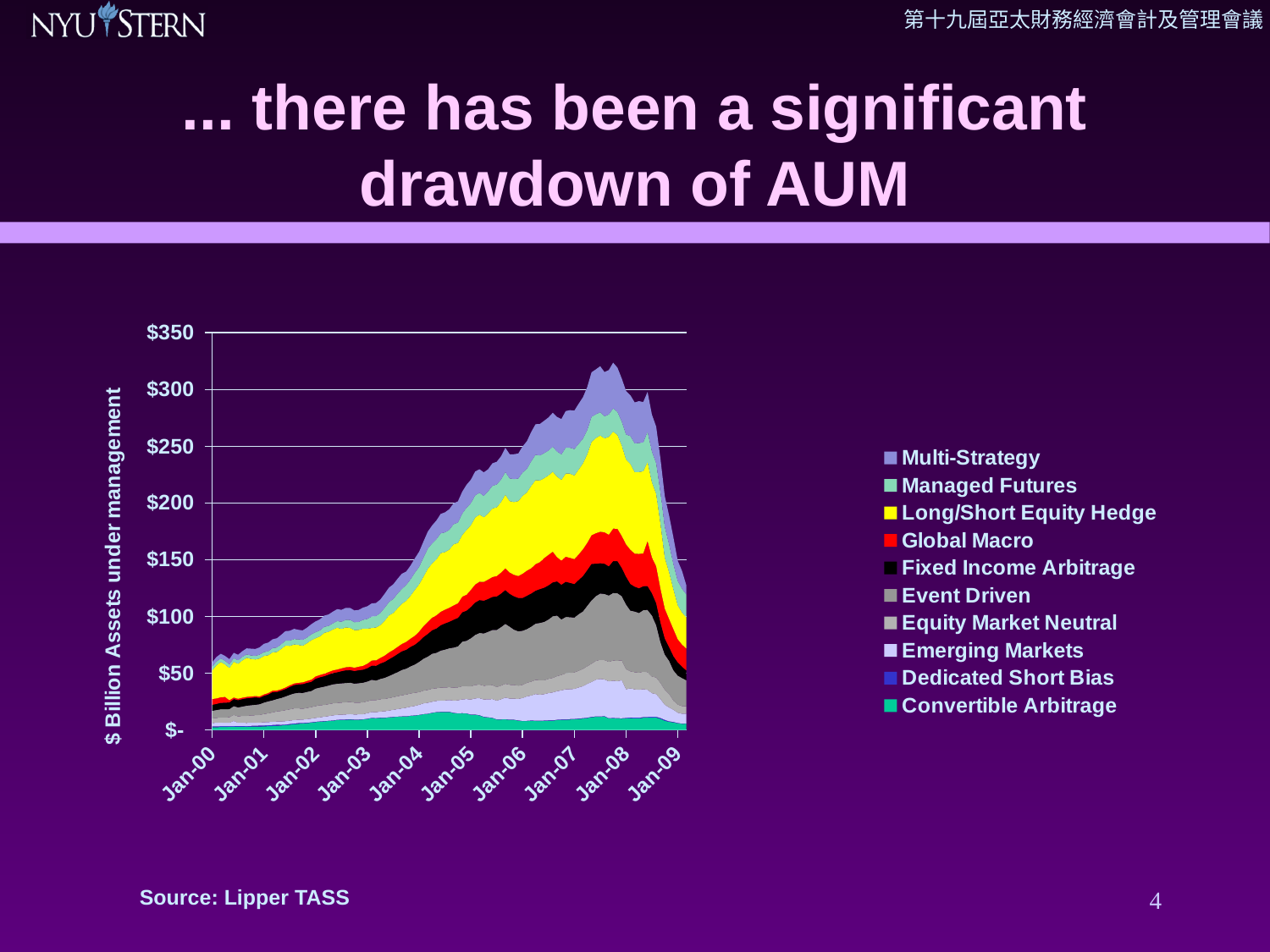
Is the peak total assets under management (around 2008) greater or less than $300? greater Is the total assets under management at Jan-09 greater or less than $200? less How many series does the legend list? 10 Is the total assets under management at Jan-05 greater or less than $200? greater Does total assets under management rise or fall from Jan-08 to Jan-09? fall Which series is listed first (at the top) in the legend? Multi-Strategy Does total assets under management rise or fall from Jan-00 to Jan-08? rise How many dates are labelled on the x axis? 10 What is the label of the y axis? $ Billion Assets under management What kind of chart is shown on the slide? stacked area chart